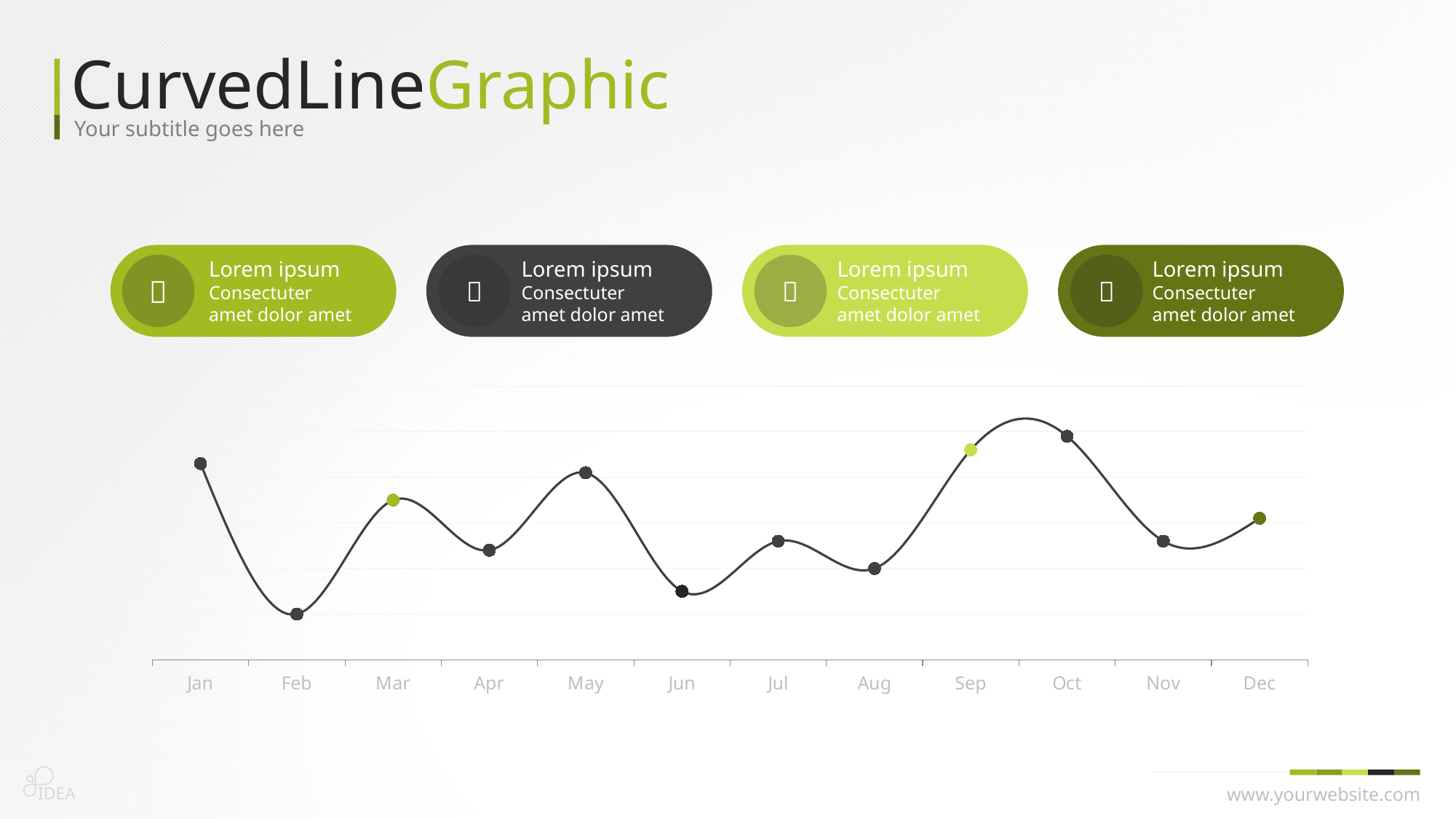
Does the line rise or fall from Jan to Feb? fall Which is higher, the value for Jul or the value for Aug? Jul What is the title of the slide containing the chart? Curved Line Graphic Which month has the lowest point on the line? Feb Which is higher, the value for Mar or the value for Apr? Mar What is the first month label on the x axis of the chart? Jan Which month has the highest plotted point on the line? Oct Which is higher, the value for May or the value for Jun? May Does the line rise or fall from Aug to Oct? rise How many months are plotted along the x axis of the chart? 12 What kind of chart is shown on the slide? line chart